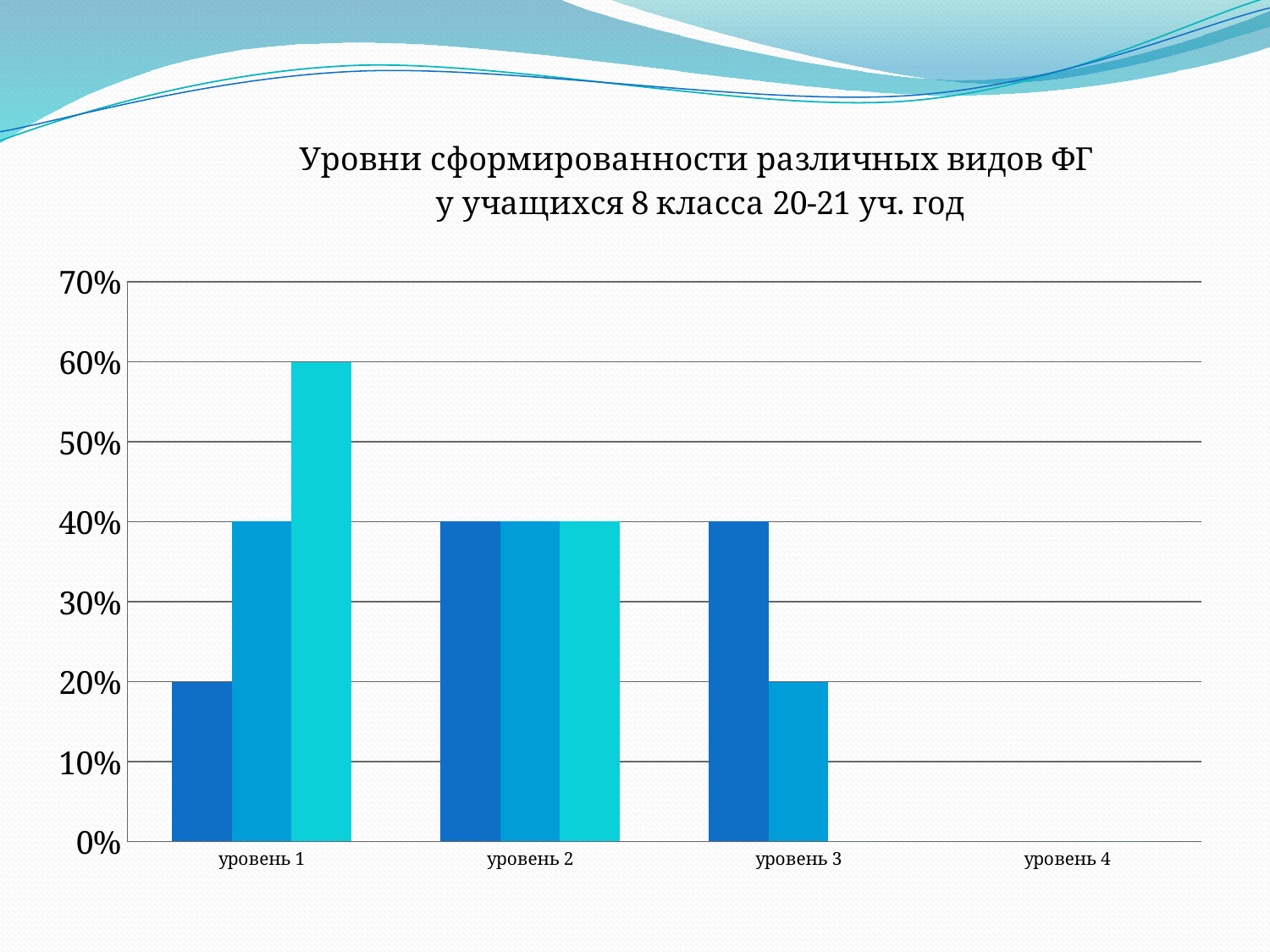
How many bars are plotted for уровень 2? 3 Is the value of the light cyan bar for уровень 1 greater or less than 50%? greater How many categories are shown on the x axis of the chart? 4 What is the value of the medium blue (second) bar for уровень 2? 40% For уровень 3, which bar is taller: the dark blue (first) bar or the medium blue (second) bar? the dark blue (first) bar What is the title of the chart? Уровни сформированности различных видов ФГ у учащихся 8 класса 20-21 уч. год What is the difference between the light cyan bar and the dark blue bar for уровень 1? 40% What is the value of the light cyan (third) bar for уровень 1? 60% What kind of chart is shown on the slide? bar chart Which category contains the tallest bar in the chart? уровень 1 What is the value of the dark blue (first) bar for уровень 3? 40% What is the value of the dark blue (first) bar for уровень 1? 20%